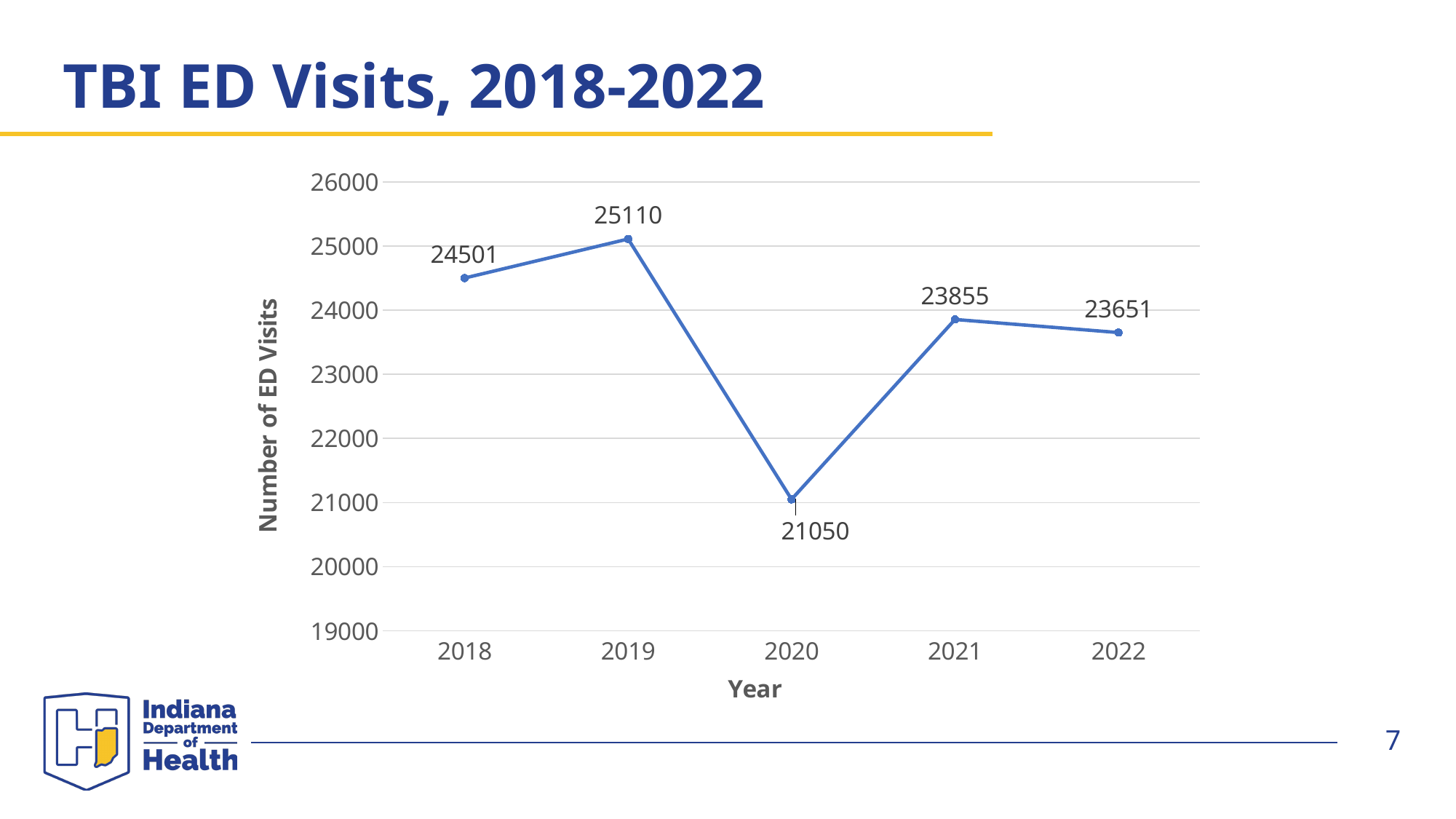
What is the number of ED visits in 2020? 21050 What is the label of the y axis? Number of ED Visits Which year has the highest number of ED visits? 2019 What is the difference in ED visits between 2018 and 2022? 850 Which year has the lowest number of ED visits? 2020 What is the difference in ED visits between 2019 and 2020? 4060 What kind of chart is shown on the slide? line chart Which year had more ED visits, 2021 or 2022? 2021 What is the number of ED visits in 2019? 25110 How many years are plotted on the chart? 5 Is the value for 2020 greater or less than 22000? less What is the number of ED visits in 2022? 23651